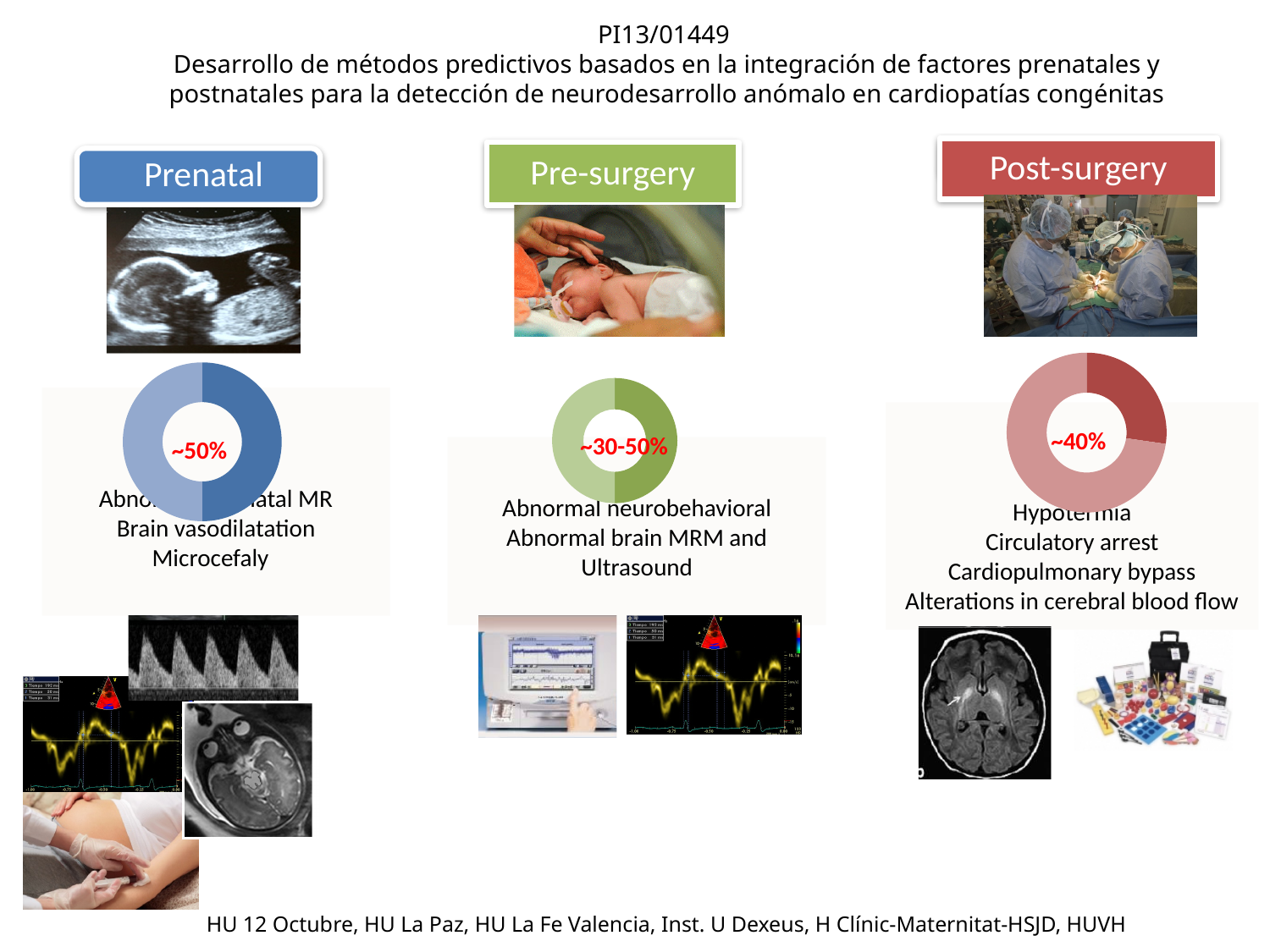
What percentage label is printed in the centre of the Pre-surgery donut chart? ~30-50% What colour scheme is used for the Pre-surgery donut chart? Green How many donut charts are on the slide? 3 What percentage label is printed in the centre of the Prenatal donut chart? ~50% What kind of chart is shown under the Prenatal heading? Donut (pie) chart What colour scheme is used for the Post-surgery donut chart? Red/pink In the Post-surgery donut chart, is the darker red slice smaller or larger than half of the ring? Smaller How many slices does the Prenatal donut chart have? 2 How many slices does the Post-surgery donut chart have? 2 Which is larger, the percentage shown in the Prenatal donut chart or the percentage shown in the Post-surgery donut chart? Prenatal What percentage label is printed in the centre of the Post-surgery donut chart? ~40%